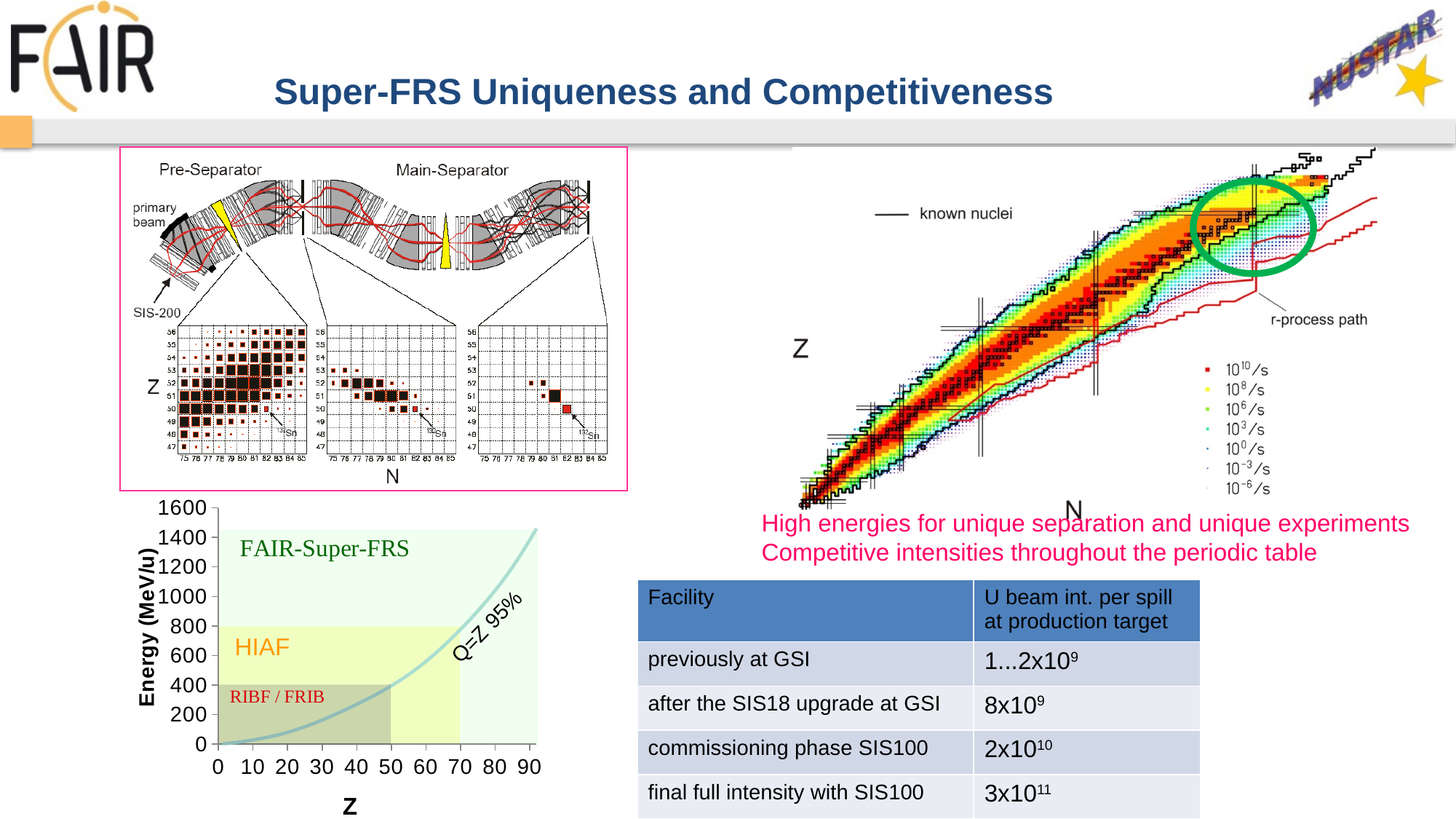
In the Energy vs Z chart, what is the maximum Z value of the RIBF / FRIB region? 50 In the Energy vs Z chart, what is the upper energy boundary of the HIAF region? 800 In the Energy vs Z chart, what is the highest tick value shown on the y axis? 1600 In the Energy vs Z chart, does the Q=Z 95% curve rise or fall as Z increases? rise In the Energy vs Z chart, is the energy of the Q=Z 95% curve at Z = 90 greater or less than 1200? greater In the Energy vs Z chart, how many facility regions are labelled? 3 In the Energy vs Z chart, what is the label of the x axis? Z In the Energy vs Z chart, what is the upper energy boundary of the RIBF / FRIB region? 400 In the Energy vs Z chart, which labelled facility region reaches the lowest energy? RIBF / FRIB In the Energy vs Z chart, which region extends to a higher Z value, HIAF or RIBF / FRIB? HIAF In the Energy vs Z chart, which labelled facility region reaches the highest energy? FAIR-Super-FRS In the Energy vs Z chart, what is the label of the y axis? Energy (MeV/u)